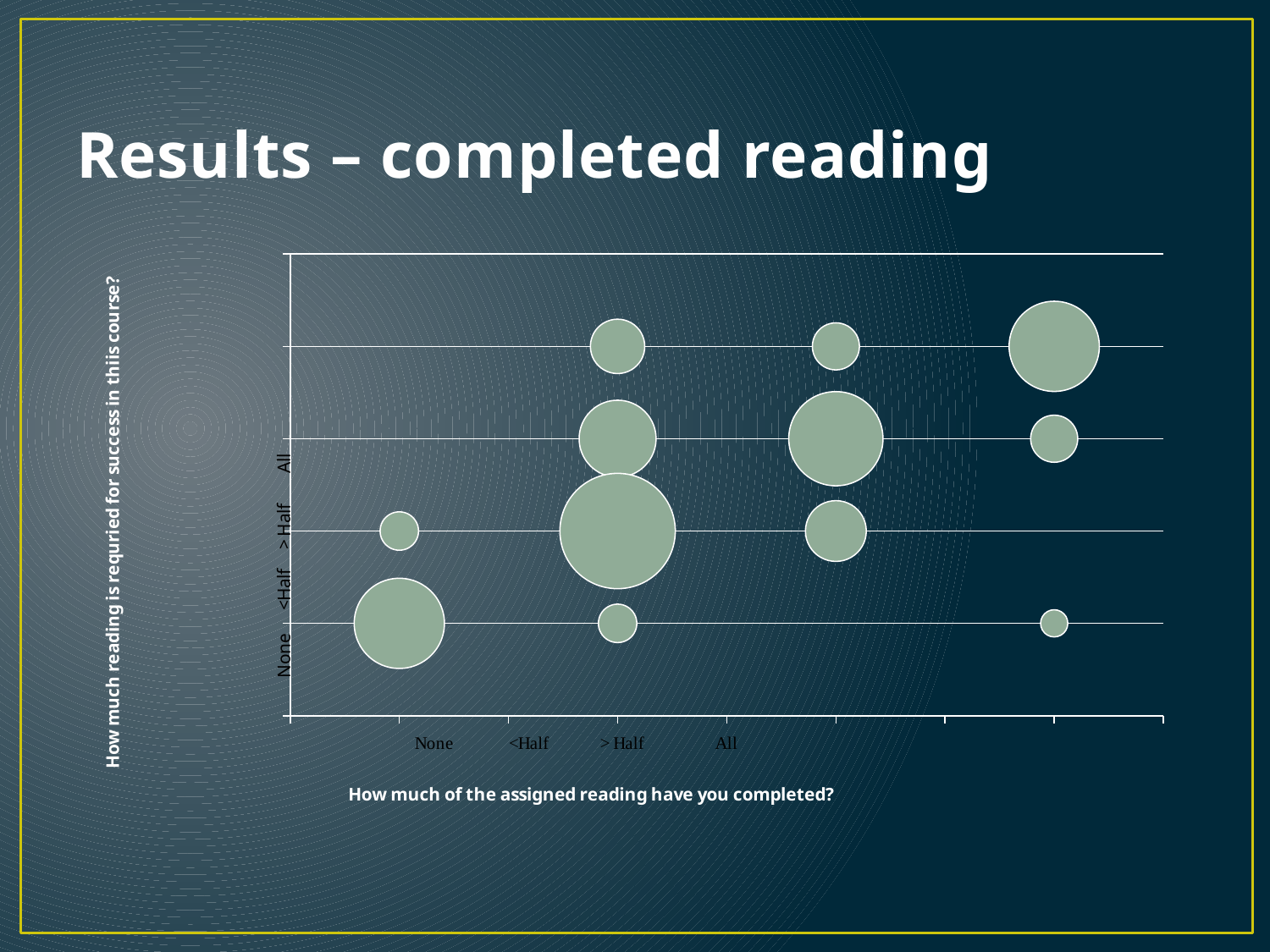
How many horizontal rows of bubbles does the chart have? 4 How many bubbles are in the bottom row of the chart? 3 What is the title of the vertical axis? How much reading is requried for success in thiis course? How many bubbles are plotted on the chart? 12 What is the title of the horizontal axis? How much of the assigned reading have you completed? Where is the largest bubble on the chart located? second column from the left, third row from the top In the top row, which bubble is larger: the rightmost one or the leftmost one? the rightmost one In the second row from the top, which bubble is larger: the middle one or the rightmost one? the middle one In the bottom row, which bubble is larger: the leftmost one or the middle one? the leftmost one What kind of chart is shown on the slide? bubble chart Where is the smallest bubble on the chart located? bottom right